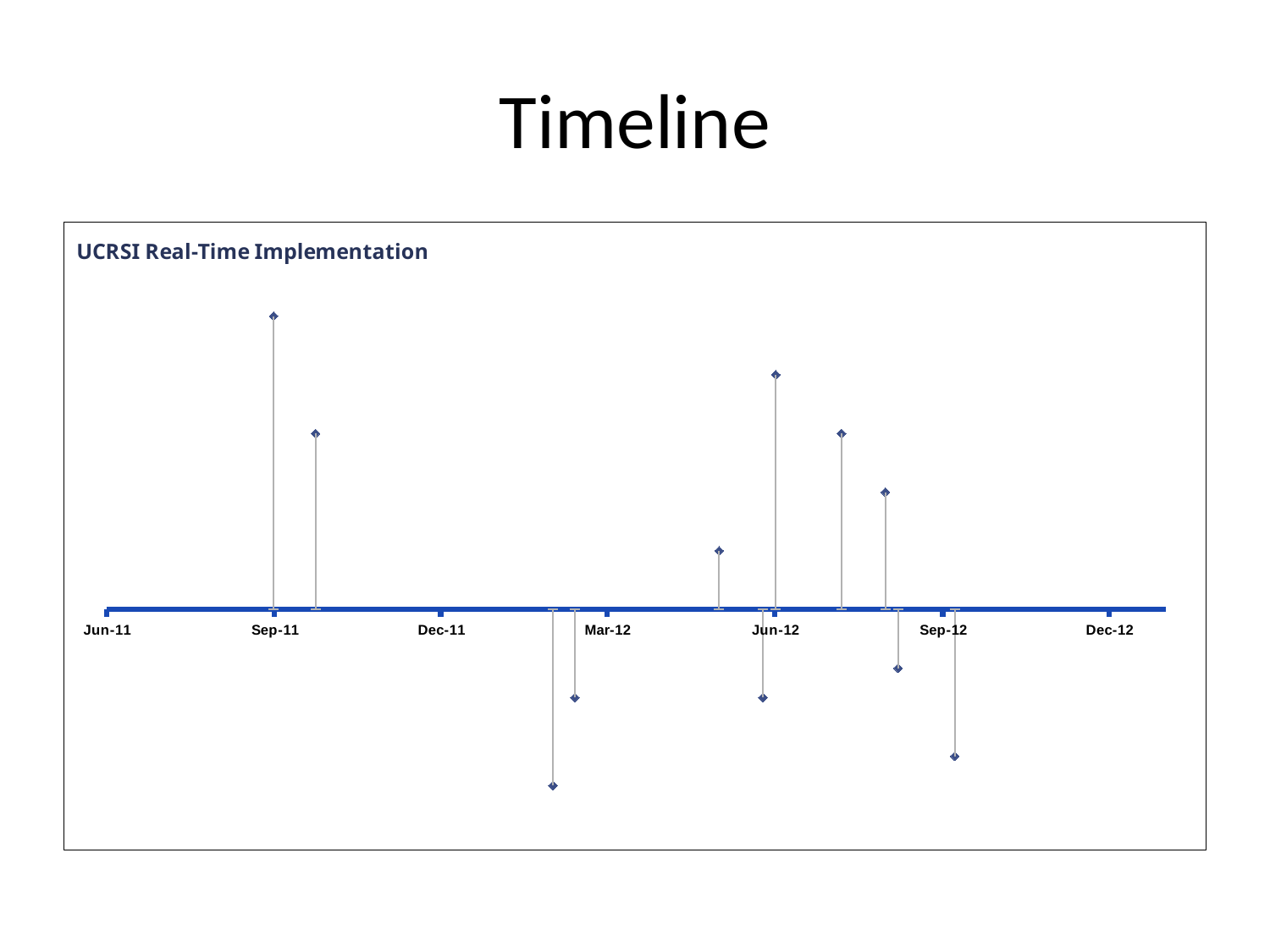
Are there more milestone markers above the axis or below it? Above Does the timeline chart include a legend? No Near which x-axis date label does the earliest milestone marker appear? Sep-11 What is the first date label on the x axis of the timeline chart? Jun-11 What is the title of the chart on the slide? UCRSI Real-Time Implementation How many milestone markers are placed below the timeline axis? 5 What is the last date label on the x axis of the timeline chart? Dec-12 How many milestone markers are plotted on the timeline chart? 11 How many milestone markers are placed above the timeline axis? 6